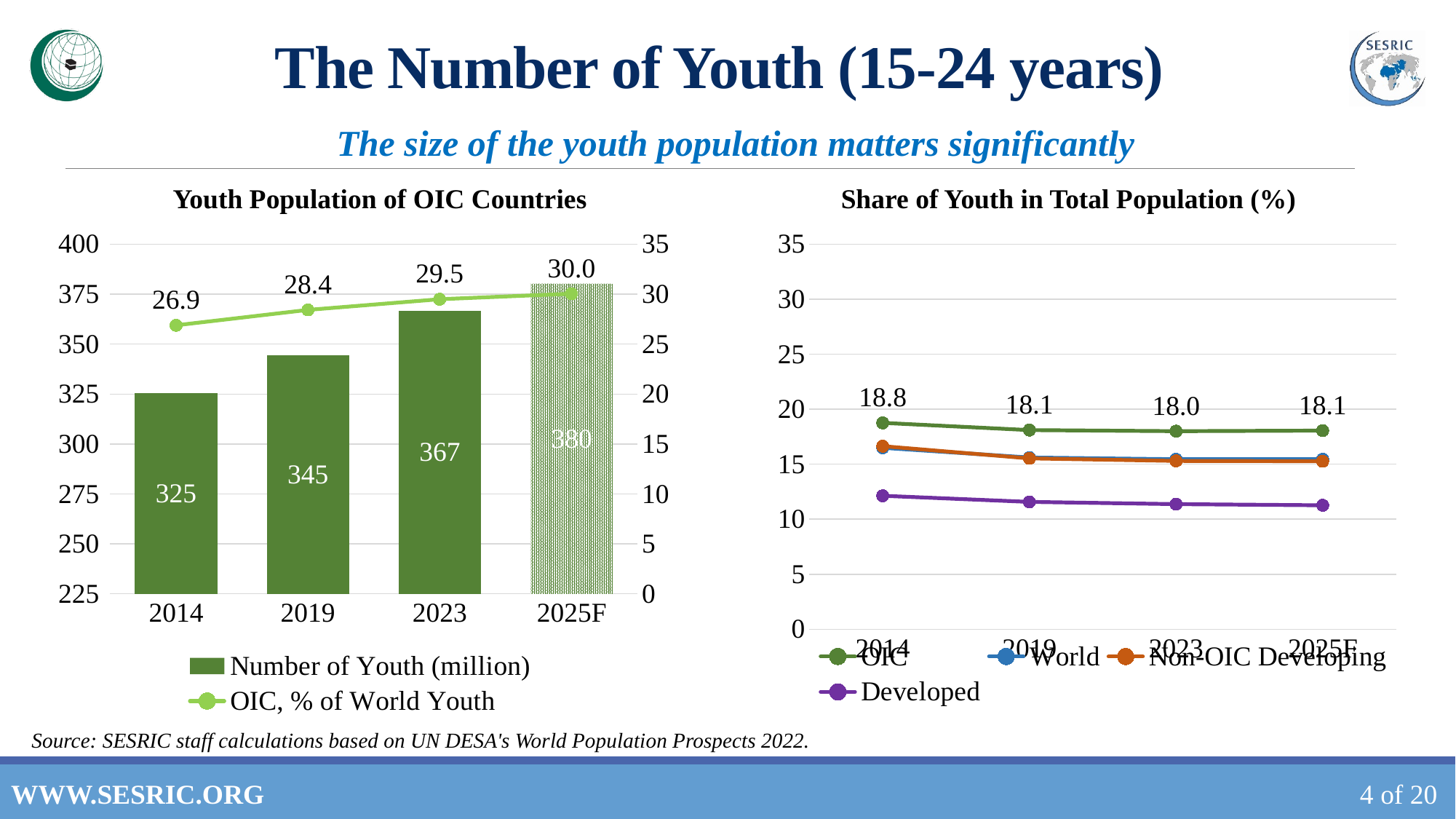
How many series does the legend of the 'Youth Population of OIC Countries' chart list? 2 In the 'Youth Population of OIC Countries' chart, what is the OIC, % of World Youth value for 2014? 26.9 In the 'Share of Youth in Total Population (%)' chart, which is larger in 2014: the OIC value or the Developed value? OIC In the 'Share of Youth in Total Population (%)' chart, is the Developed value for 2014 greater or less than 15? less How many series does the legend of the 'Share of Youth in Total Population (%)' chart list? 4 In the 'Youth Population of OIC Countries' chart, what is the Number of Youth (million) for 2023? 367 In the 'Share of Youth in Total Population (%)' chart, what is the OIC value for 2023? 18.0 In the 'Youth Population of OIC Countries' chart, does the OIC, % of World Youth rise or fall from 2014 to 2025F? rise In the 'Share of Youth in Total Population (%)' chart, which series has the lowest values across all years? Developed In the 'Youth Population of OIC Countries' chart, what is the difference in Number of Youth (million) between 2025F and 2014? 55 How many years are shown on the x axis of the 'Share of Youth in Total Population (%)' chart? 4 In the 'Youth Population of OIC Countries' chart, which year has the highest Number of Youth (million)? 2025F